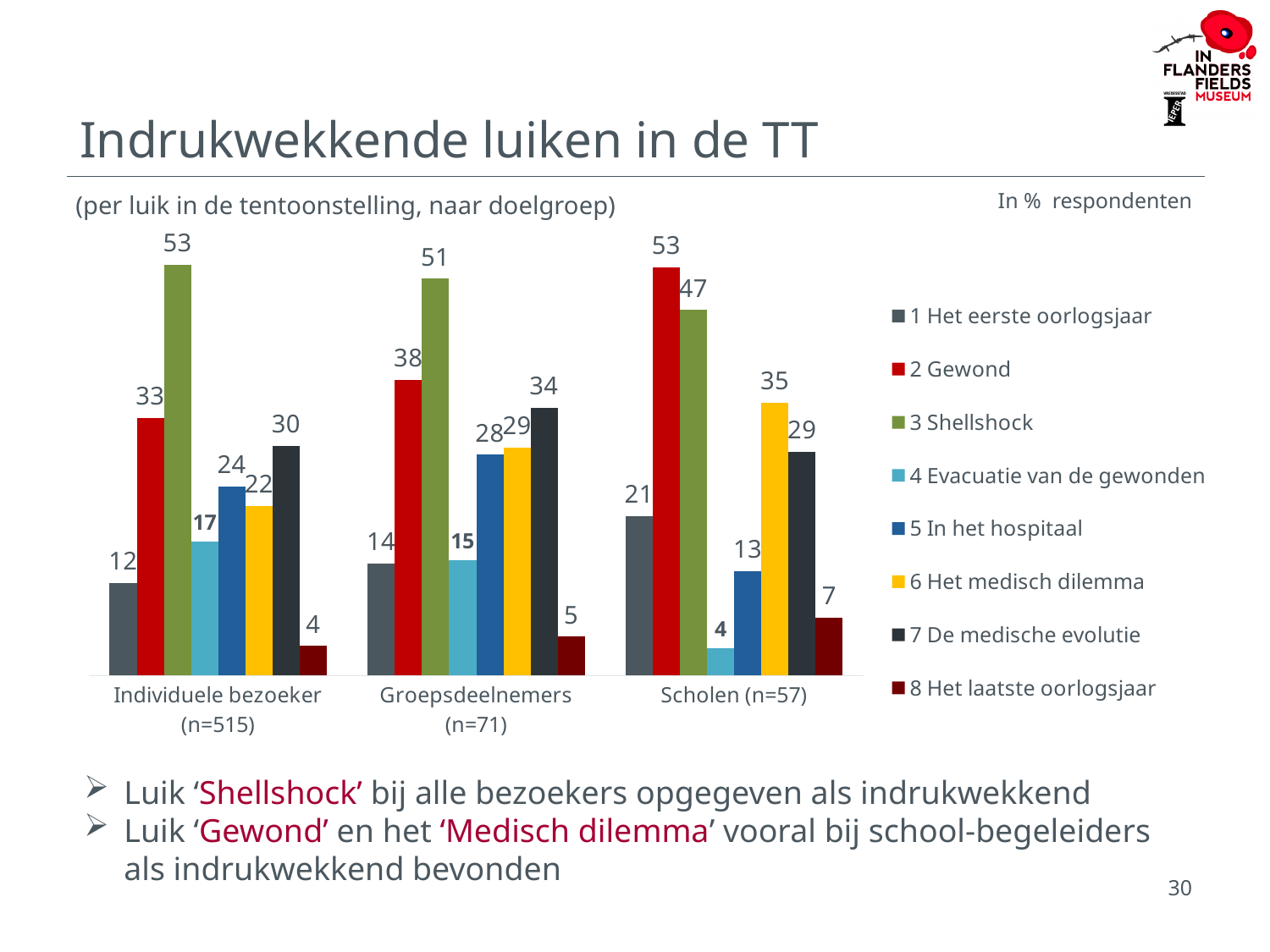
What is the value for '3 Shellshock' in the 'Individuele bezoeker (n=515)' group? 53 What is the value for '6 Het medisch dilemma' in the 'Groepsdeelnemers (n=71)' group? 29 How many series does the legend list? 8 What is the value for '8 Het laatste oorlogsjaar' in the 'Groepsdeelnemers (n=71)' group? 5 Which series has the lowest value in the 'Scholen (n=57)' group? 4 Evacuatie van de gewonden What is the title of the chart on the slide? Indrukwekkende luiken in de TT What is the difference between '3 Shellshock' and '2 Gewond' in the 'Individuele bezoeker (n=515)' group? 20 How many groups of bars are shown on the x axis? 3 Which series has the highest value in the 'Groepsdeelnemers (n=71)' group? 3 Shellshock Which is larger in the 'Scholen (n=57)' group: '2 Gewond' or '3 Shellshock'? 2 Gewond What is the value for '2 Gewond' in the 'Scholen (n=57)' group? 53 What kind of chart is shown on the slide? Bar chart